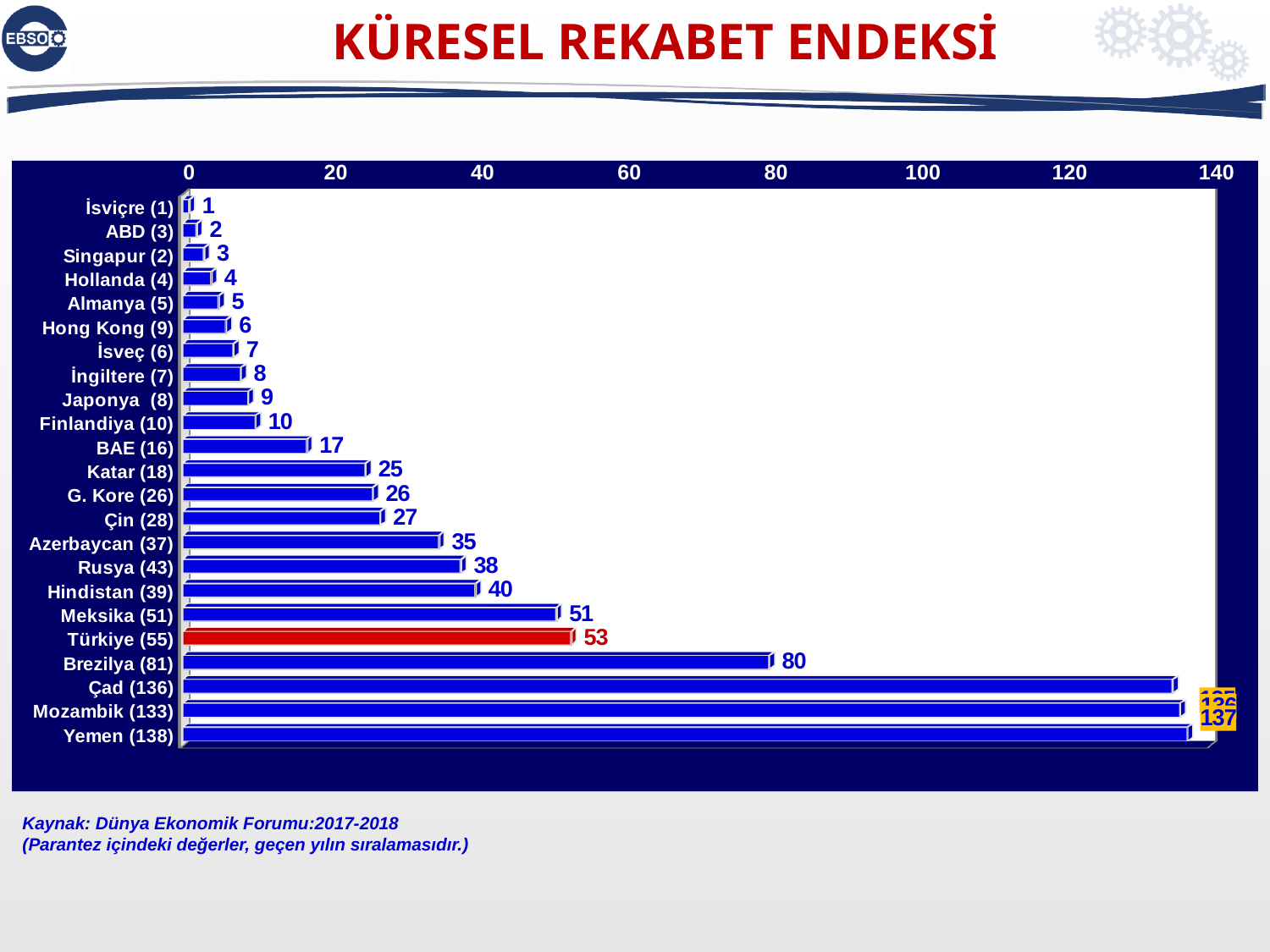
What is the value for Azerbaycan (37)? 35 What is the difference between the values for Çin (28) and Katar (18)? 2 Which category's bar is coloured red instead of blue? Türkiye (55) What kind of chart is shown on the slide? bar chart Is the value for Yemen (138) greater or less than 120? greater Which category has the lowest value? İsviçre (1) What is the value for Meksika (51)? 51 What is the difference between the values for Brezilya (81) and Türkiye (55)? 27 What is the value for Brezilya (81)? 80 What is the value for Türkiye (55)? 53 How many categories are shown in the chart? 23 Which is larger, the value for Rusya (43) or the value for Hindistan (39)? Hindistan (39)